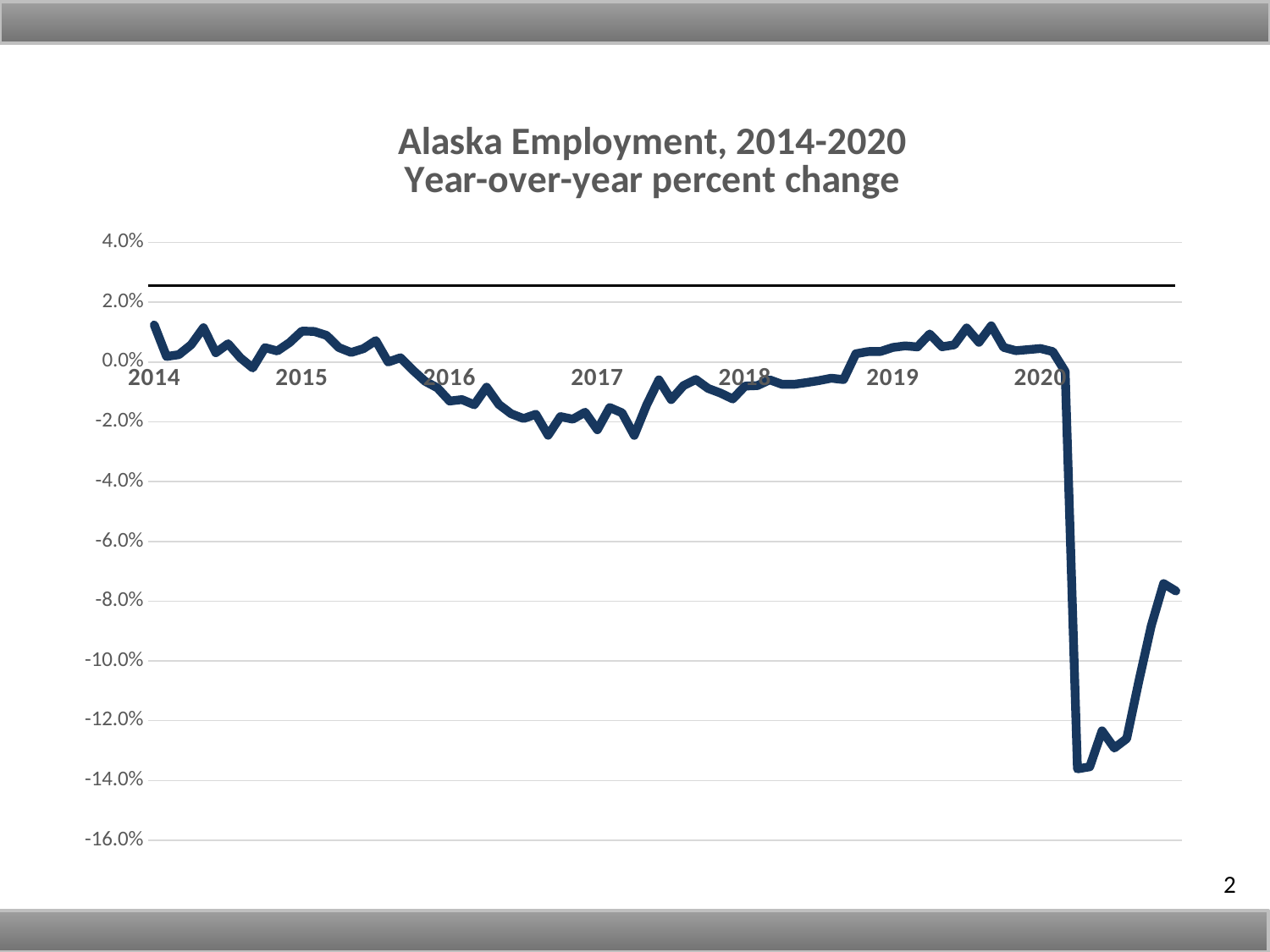
Is the lowest value in 2020 greater or less than -12.0%? less What kind of chart is shown on the slide? line chart How many year labels appear on the x axis? 7 Is the value at the start of 2017 greater or less than 0.0%? less What is the highest value shown on the y axis? 4.0% Is the value at the start of 2019 greater or less than -2.0%? greater In which year does the line reach its lowest value? 2020 What is the title of the chart? Alaska Employment, 2014-2020 Year-over-year percent change Is the value at the start of 2020 larger or smaller than the value at the start of 2017? larger Does the line rise or fall between the start of 2020 and the lowest point in 2020? fall